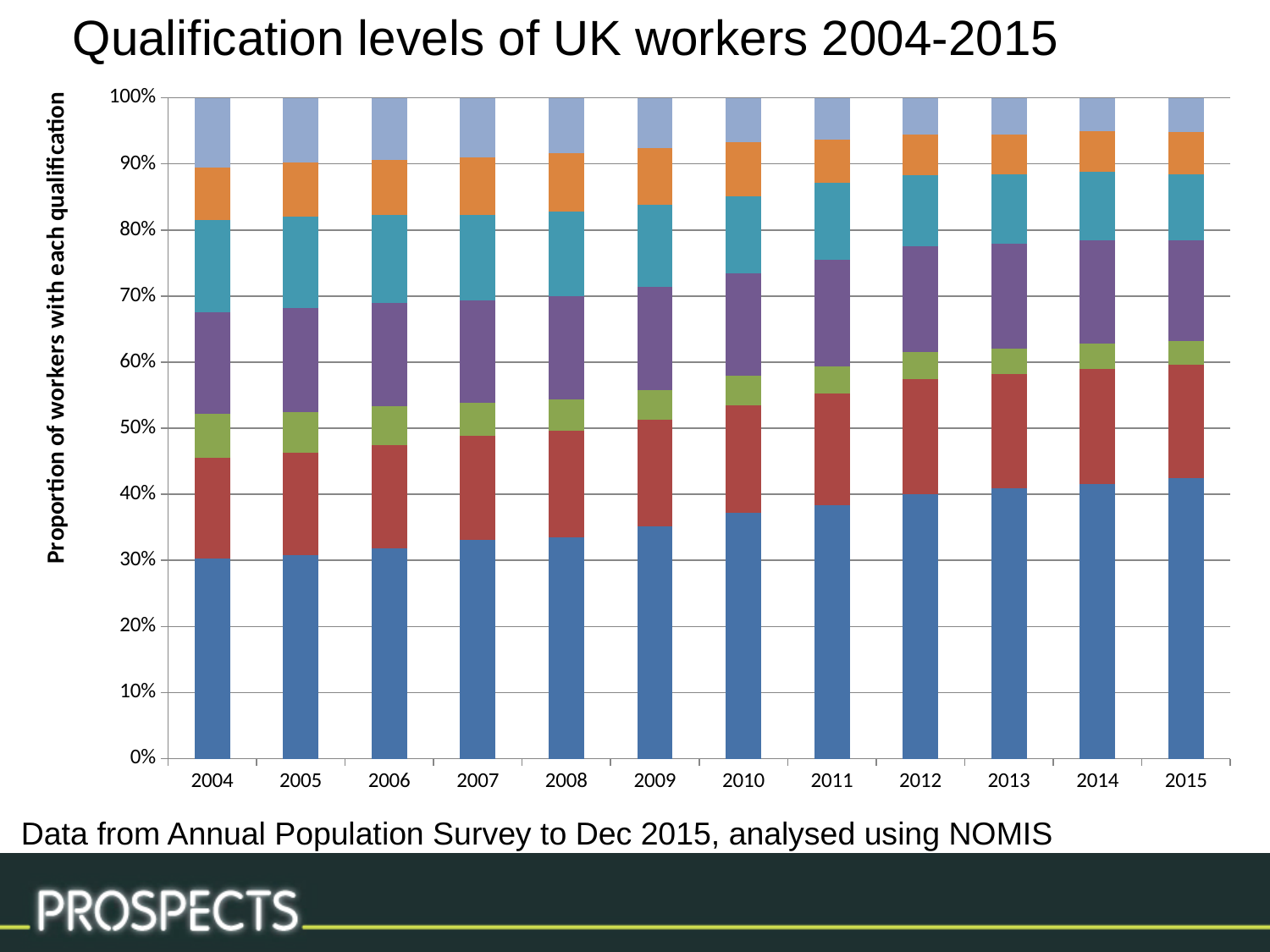
Is the bottom (dark blue) segment for 2015 greater or less than 40%? greater What is the total height of the stacked bar for 2004? 100% What is the label on the y axis of the chart? Proportion of workers with each qualification Is the bottom (dark blue) segment for 2004 greater or less than 20%? greater Is the bottom (dark blue) segment for 2004 greater or less than 40%? less Does the top (light blue) segment grow or shrink from 2004 to 2015? shrink What kind of chart is shown on the slide? stacked bar chart How many years are shown along the x axis of the chart? 12 Does the bottom (dark blue) segment rise or fall from 2004 to 2015? rise Which year has the larger bottom (dark blue) segment, 2004 or 2010? 2010 What is the title of the chart? Qualification levels of UK workers 2004-2015